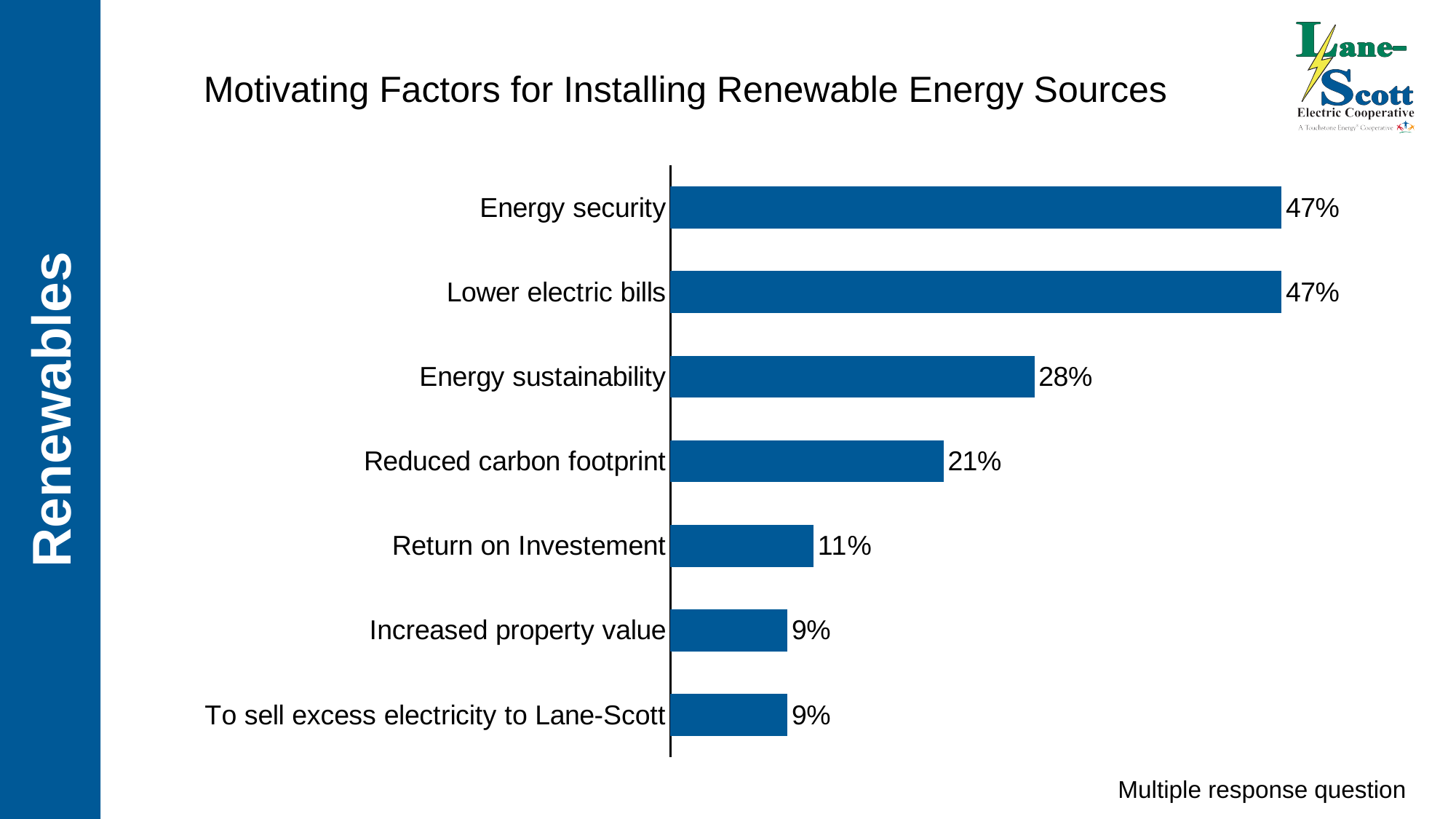
What is the difference between Reduced carbon footprint and Return on Investement? 10 percentage points How many motivating factors are shown on the chart? 7 What percentage is shown for Return on Investement? 11% What is the value for Increased property value? 9% What percentage is shown for To sell excess electricity to Lane-Scott? 9% What percentage of respondents cited Energy sustainability as a motivating factor? 28% What is the value shown for Reduced carbon footprint? 21% What is the title of the chart? Motivating Factors for Installing Renewable Energy Sources Which is larger, the value for Energy sustainability or the value for Reduced carbon footprint? Energy sustainability What is the difference between the values for Energy security and Energy sustainability? 19 percentage points What kind of chart is shown on the slide? Bar chart